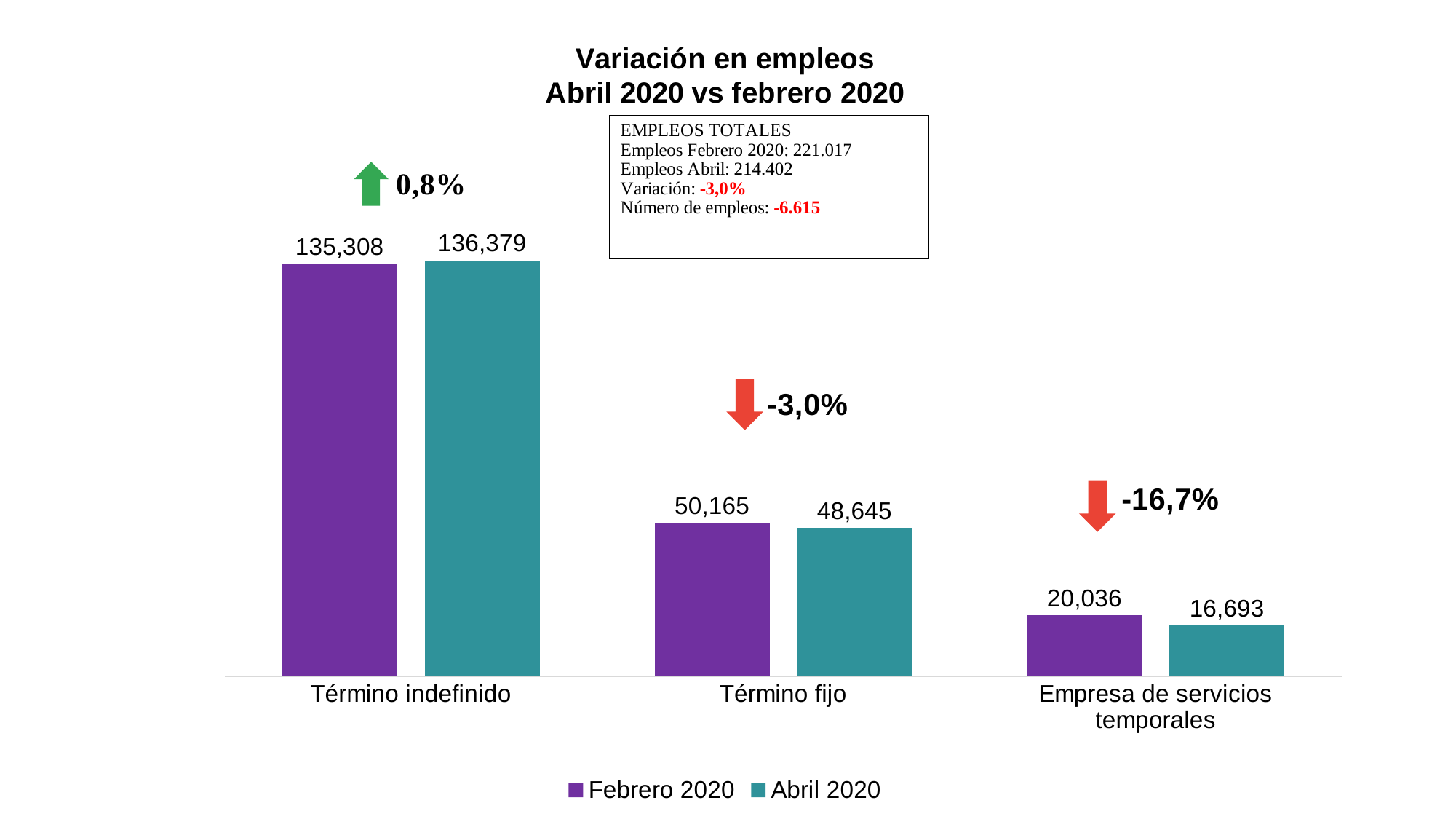
What is the difference between the Abril 2020 and Febrero 2020 values for Término indefinido? 1,071 What is the difference between the Febrero 2020 and Abril 2020 values for Término fijo? 1,520 For Empresa de servicios temporales, which is larger: the Febrero 2020 value or the Abril 2020 value? Febrero 2020 Which category has the highest value in the Febrero 2020 series? Término indefinido Which category has the lowest value in the Abril 2020 series? Empresa de servicios temporales How many categories are shown on the x axis? 3 What is the value for Empresa de servicios temporales in the Abril 2020 series? 16,693 How many series does the legend list? 2 What kind of chart is shown on the slide? Bar chart What is the value for Término indefinido in the Febrero 2020 series? 135,308 What is the value for Término fijo in the Abril 2020 series? 48,645 What percentage change is shown above the Empresa de servicios temporales bars? -16,7%